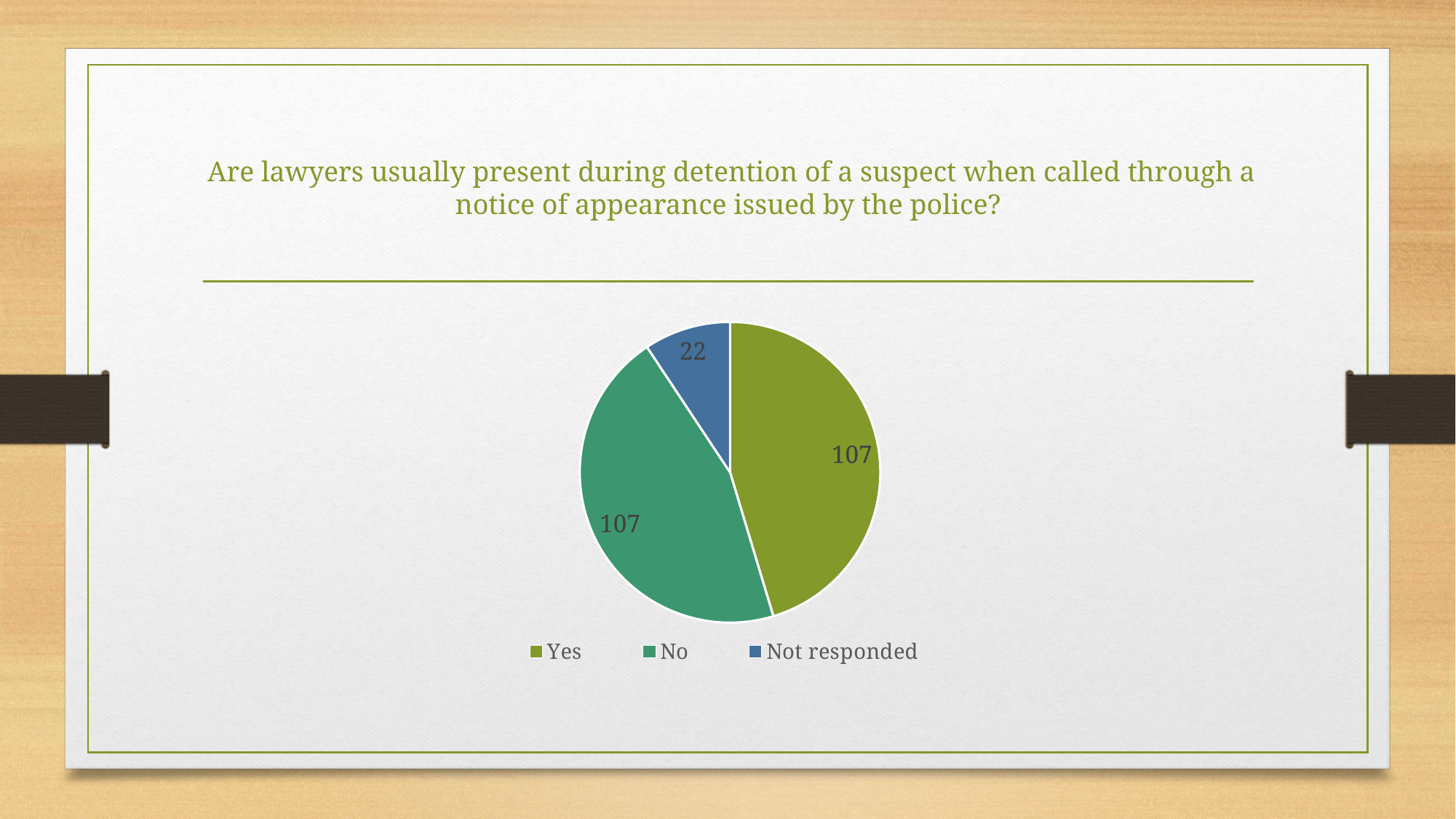
What value is shown for the Yes slice? 107 How many categories does the pie chart show? 3 What is the difference between the Yes value and the Not responded value? 85 What value is shown for the Not responded slice? 22 What is the title of the chart on the slide? Are lawyers usually present during detention of a suspect when called through a notice of appearance issued by the police? Which is larger, the No slice or the Not responded slice? No What kind of chart is shown on the slide? Pie chart What value is shown for the No slice? 107 What colour is the Not responded slice? Blue Which category has the smallest slice of the pie? Not responded What is the total of all the slices in the pie chart? 236 Are the Yes and No slices equal in value? Yes, both are 107